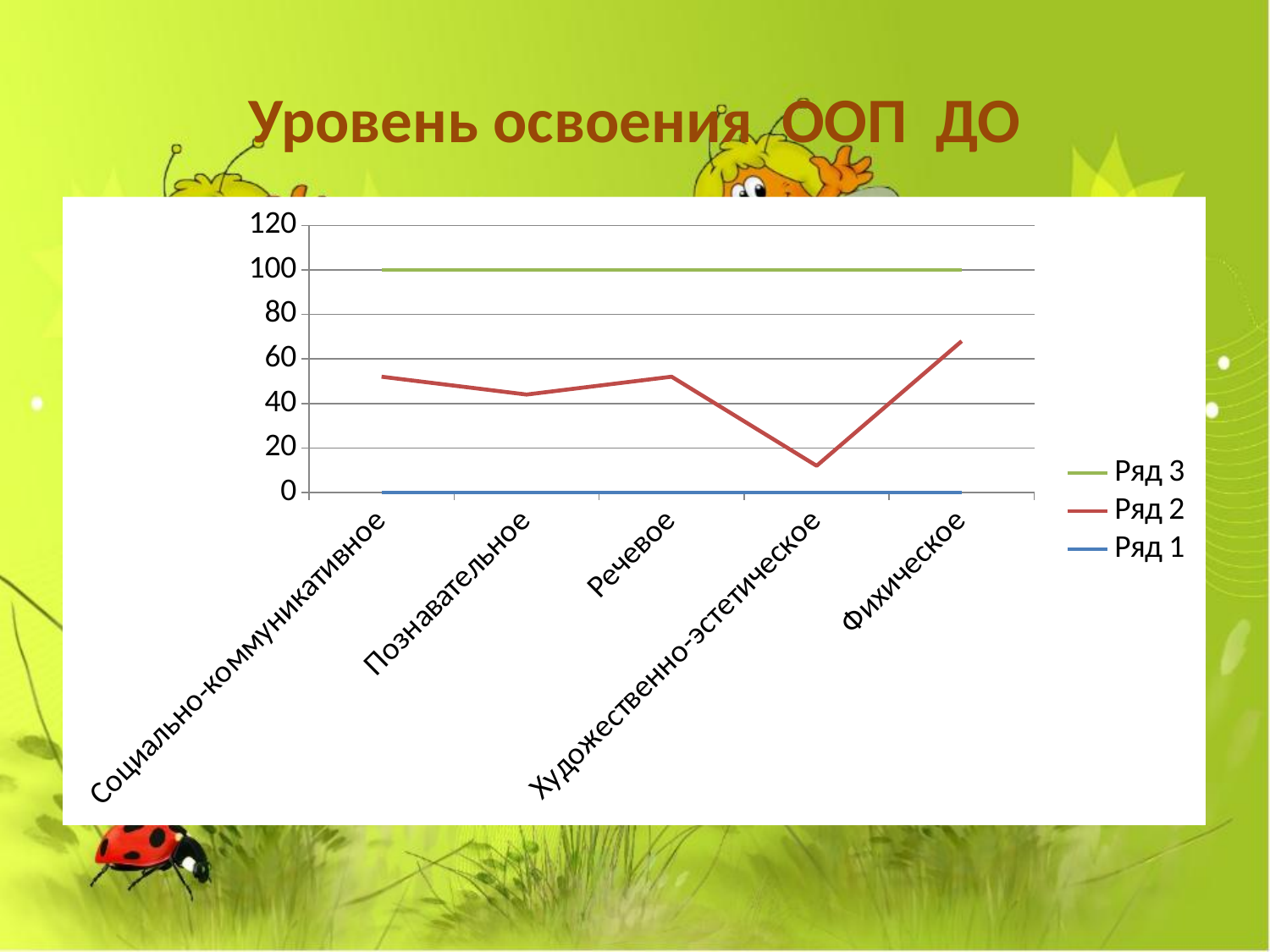
What is the value of Ряд 1 for Речевое? 0 For Ряд 2, which category has the highest value? Фихическое What kind of chart is shown on the slide? line chart For Ряд 2, which is larger: the value for Познавательное or the value for Фихическое? Фихическое How many series does the legend list? 3 Is the value of Ряд 2 for Фихическое greater or less than 60? greater What is the title of the slide? Уровень освоения ООП ДО How many categories are shown on the x axis? 5 For Ряд 2, which category has the lowest value? Художественно-эстетическое Is the value of Ряд 2 for Художественно-эстетическое greater or less than 20? less